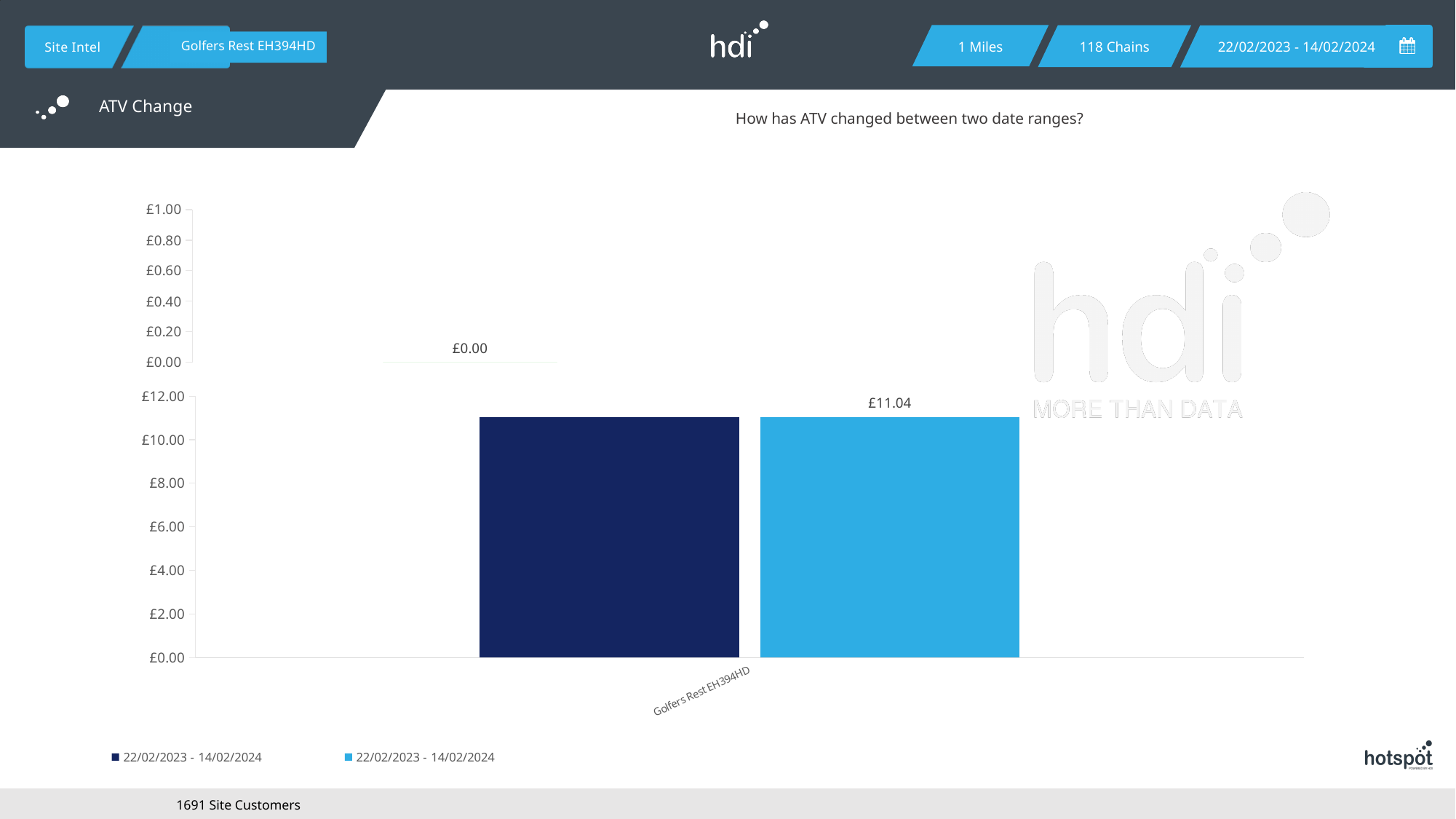
On the lower bar chart, is the value of the dark blue bar greater or less than £8.00? greater On the lower bar chart, is the value of the dark blue bar greater or less than £10.00? greater What kind of chart is the lower chart on the slide? Bar chart What is the highest tick value on the y axis of the lower bar chart? £12.00 On the small upper chart, what value is printed above the bar? £0.00 How many series does the legend at the bottom of the slide list? 2 How many categories are shown on the x axis of the lower bar chart? 1 What is the title shown in the header of the slide for this chart? ATV Change On the lower bar chart, what is the value printed above the light blue bar for Golfers Rest EH394HD? £11.04 On the lower bar chart, is the value of the light blue bar greater or less than £12.00? less What is the category label on the x axis of the lower bar chart? Golfers Rest EH394HD